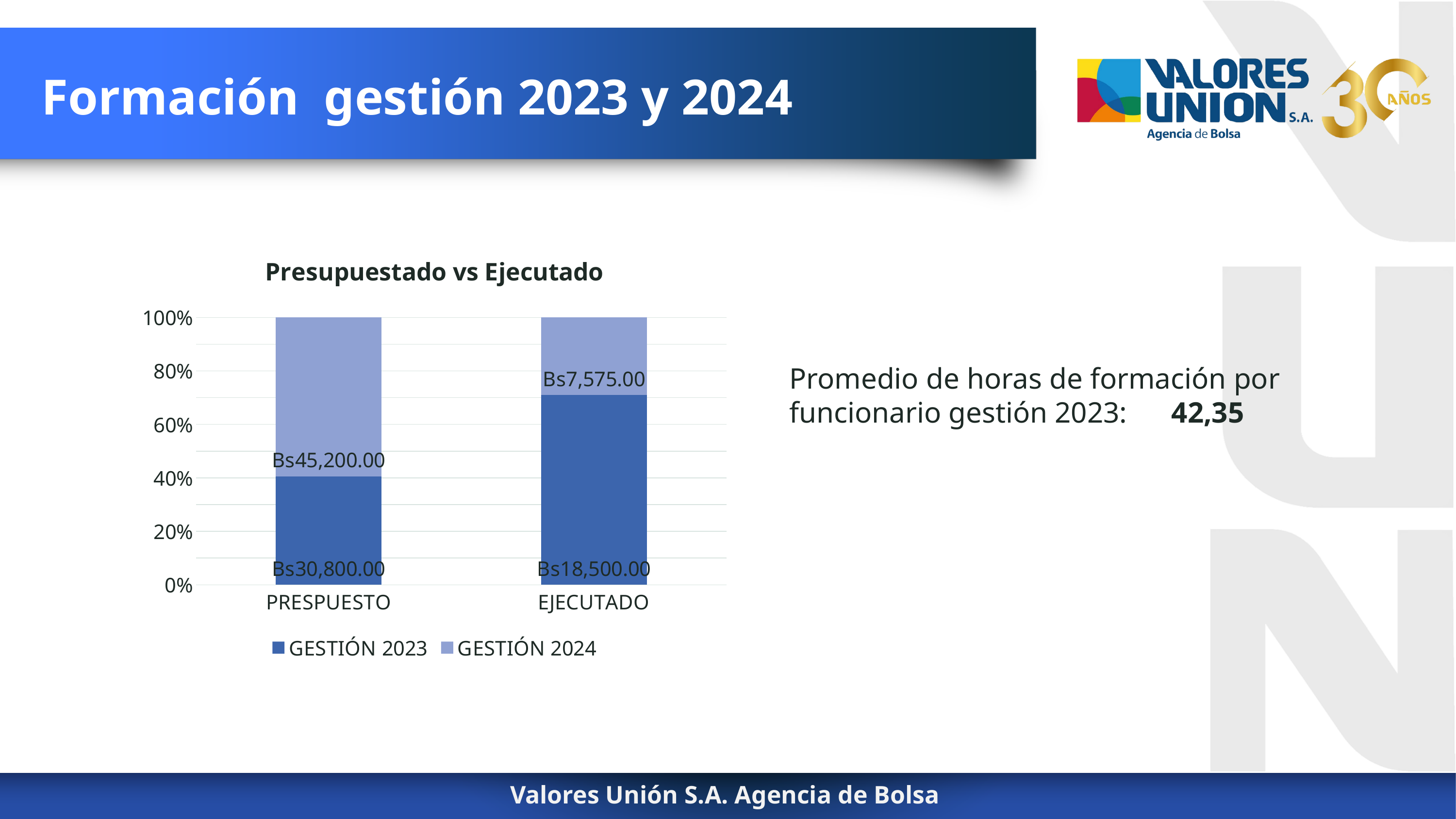
What is the value for GESTIÓN 2023 in the PRESPUESTO bar? Bs30,800.00 What is the value for GESTIÓN 2024 in the PRESPUESTO bar? Bs45,200.00 What is the value for GESTIÓN 2023 in the EJECUTADO bar? Bs18,500.00 How many categories are shown on the x axis of the chart? 2 Which category has the higher GESTIÓN 2024 value, PRESPUESTO or EJECUTADO? PRESPUESTO What is the difference between the GESTIÓN 2023 values for PRESPUESTO and EJECUTADO? Bs12,300.00 Which series has the larger value in the EJECUTADO bar, GESTIÓN 2023 or GESTIÓN 2024? GESTIÓN 2023 What is the total of the two values in the EJECUTADO bar? Bs26,075.00 How many series does the chart legend list? 2 What is the title of the chart? Presupuestado vs Ejecutado What is the difference between the GESTIÓN 2024 and GESTIÓN 2023 values in the PRESPUESTO bar? Bs14,400.00 What is the value for GESTIÓN 2024 in the EJECUTADO bar? Bs7,575.00